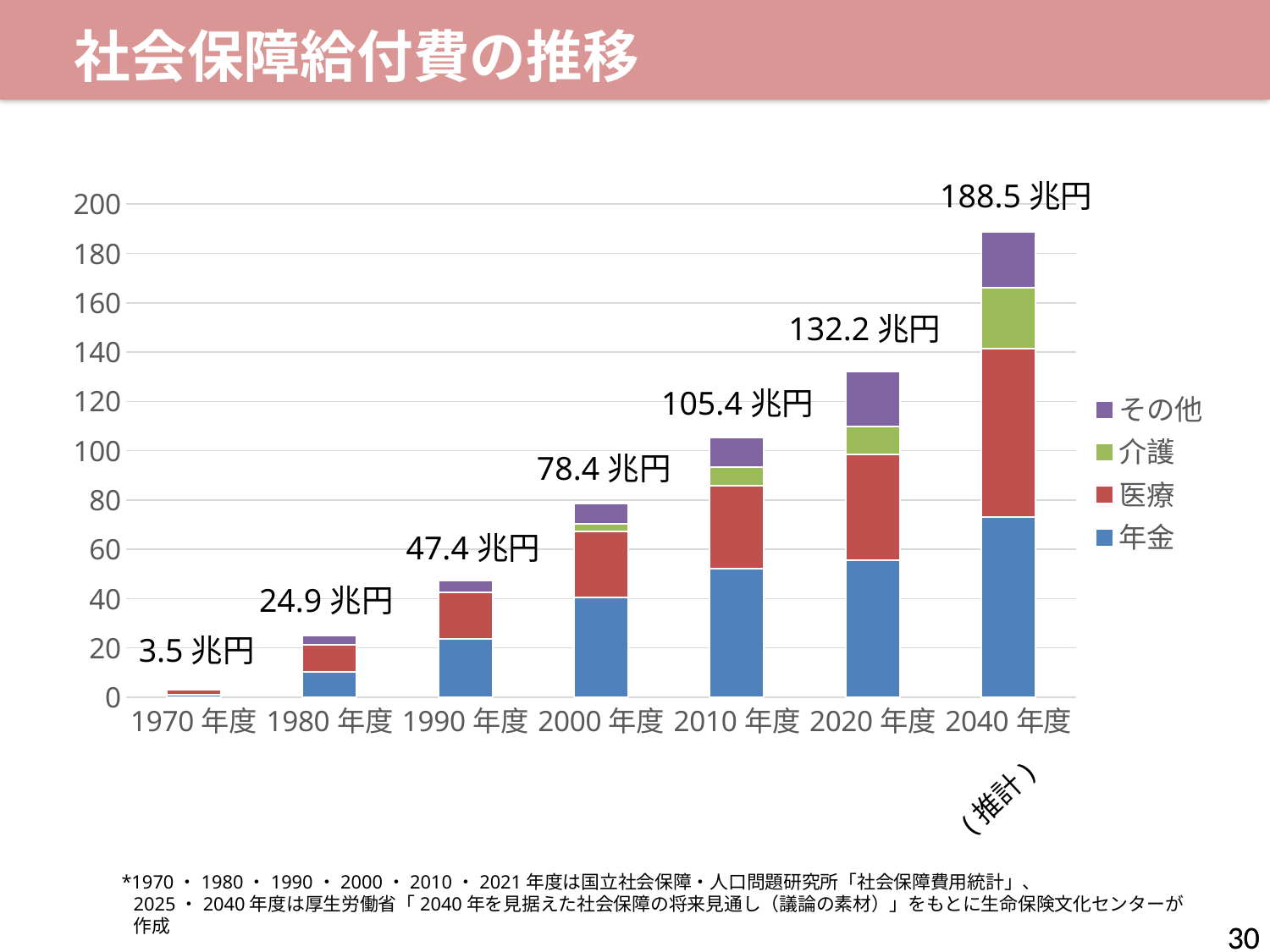
Which is larger, the total for 1990年度 or the total for 2000年度? 2000 年度 Which fiscal year has the lowest total social security benefit? 1970 年度 What kind of chart is shown on the slide? Stacked bar chart What is the difference between the totals for 2040年度 and 2020年度? 56.3 兆円 Do the total values rise or fall from 1970年度 to 2040年度? Rise What is the total social security benefit shown for 2040年度? 188.5 兆円 Which fiscal year has the highest total social security benefit? 2040 年度 Is the 年金 value for 2040年度 greater or less than 60? greater How many series does the legend list? 4 What is the total value labeled for 2010年度? 105.4 兆円 What is the total value labeled for 1970年度? 3.5 兆円 How many fiscal years are shown on the x axis? 7